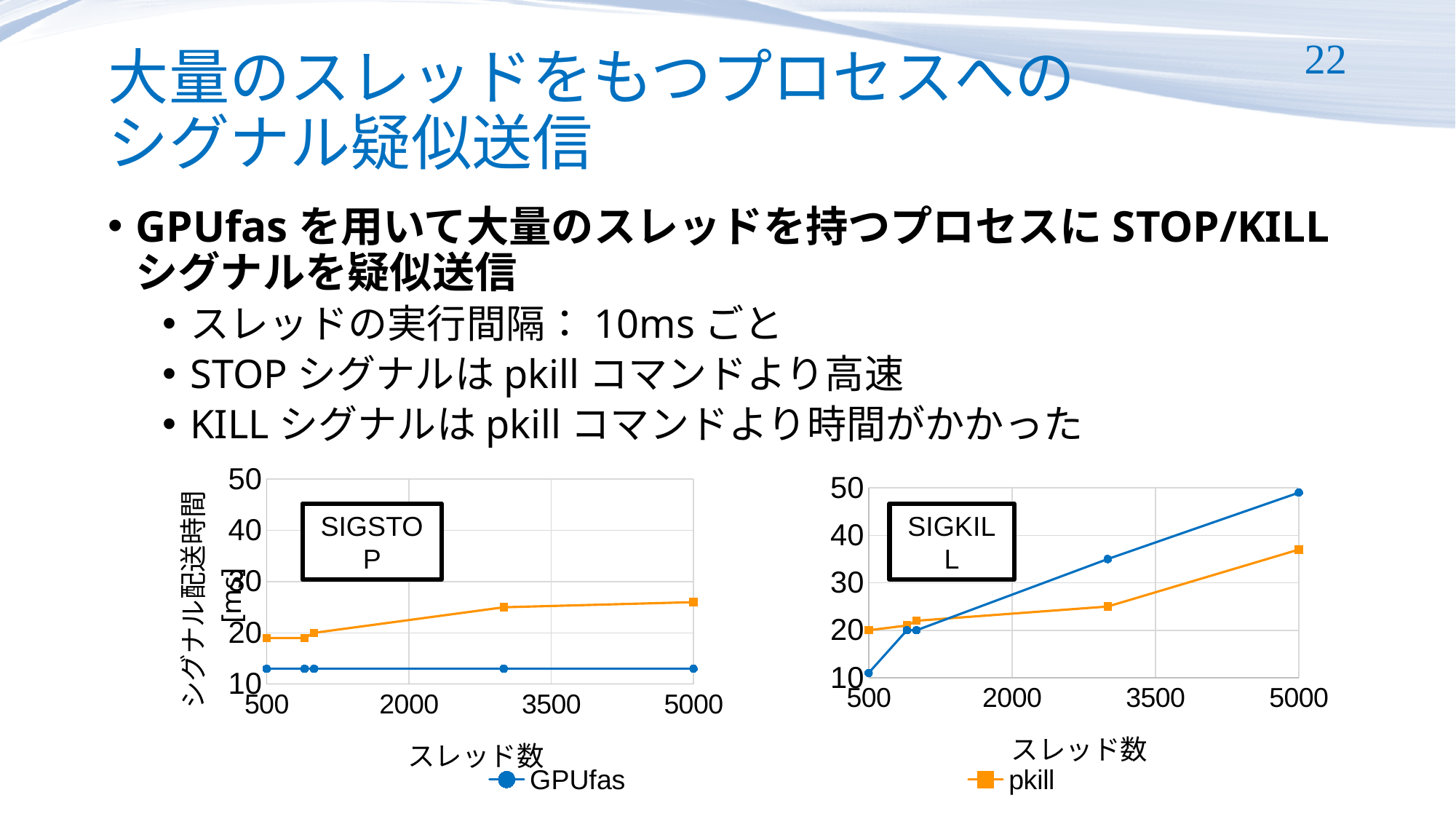
In the SIGKILL chart, is the GPUfas value at 5000 threads greater or less than 40? greater What is the x-axis label of the SIGSTOP chart? スレッド数 In the SIGSTOP chart, is the GPUfas value at 5000 threads greater or less than 20? less In the SIGKILL chart, does the GPUfas line rise or fall as the number of threads increases? rise In the SIGSTOP chart, which series has the higher value at 5000 threads, GPUfas or pkill? pkill What kind of chart is the SIGKILL chart on the right? line chart In the SIGKILL chart, which series has the higher value at 5000 threads, GPUfas or pkill? GPUfas How many series does the legend at the bottom of the slide list? 2 In the SIGSTOP chart, does the pkill line rise or fall as the number of threads increases? rise What kind of chart is the SIGSTOP chart on the left? line chart In the SIGKILL chart, is the pkill value at 5000 threads greater or less than 40? less